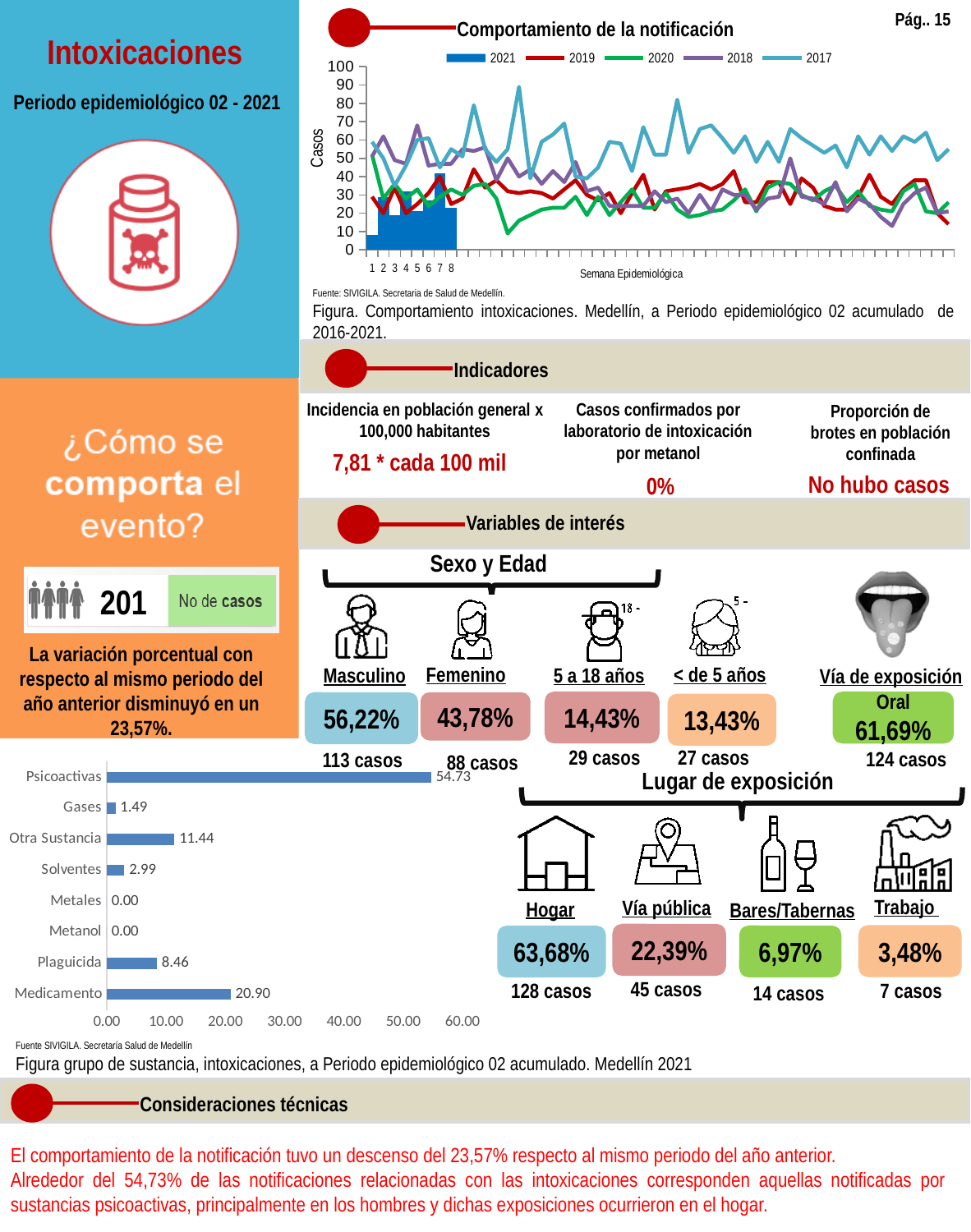
In the bottom-left bar chart of substance groups, which two categories show a value of 0.00? Metales and Metanol What kind of chart is the bottom-left chart of substance groups? Bar chart How many series does the legend of the 'Comportamiento de la notificación' chart list? 5 How many categories are shown in the bottom-left bar chart of substance groups? 8 In the 'Comportamiento de la notificación' chart, which series is drawn as bars rather than a line? 2021 In the bottom-left bar chart of substance groups, what is the difference between the values for Psicoactivas and Medicamento? 33.83 In the bottom-left bar chart of substance groups, what is the value for Medicamento? 20.90 In the 'Comportamiento de la notificación' chart, is the 2021 value at week 1 greater or less than 10? less In the bottom-left bar chart of substance groups, what is the value for Psicoactivas? 54.73 In the bottom-left bar chart of substance groups, which category has the highest value? Psicoactivas In the bottom-left bar chart of substance groups, which is larger, the value for Plaguicida or for Solventes? Plaguicida In the bottom-left bar chart of substance groups, what is the value for Plaguicida? 8.46